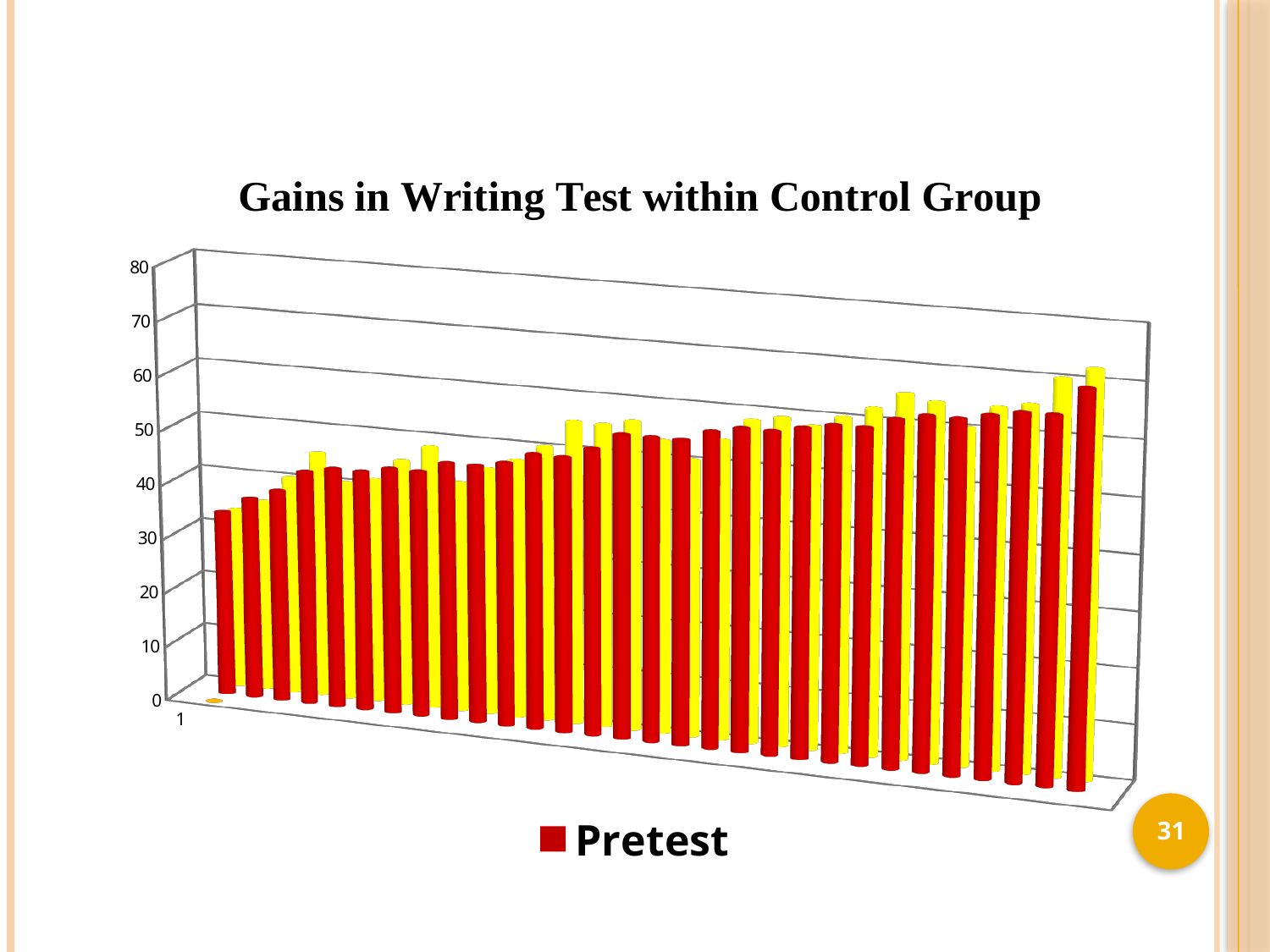
What is the title of the chart? Gains in Writing Test within Control Group Is the value of the leftmost red Pretest bar greater or less than 40? less Do the red Pretest bars generally rise or fall from left to right? rise Is the value of the rightmost red Pretest bar greater or less than 50? greater Is the value of the rightmost yellow bar greater or less than 50? greater Which is larger, the leftmost red Pretest bar or the rightmost red Pretest bar? the rightmost red Pretest bar How many series does the chart's legend list? 1 What kind of chart is shown on the slide? bar chart What is the highest value shown on the vertical axis? 80 Which series is named in the chart's legend? Pretest